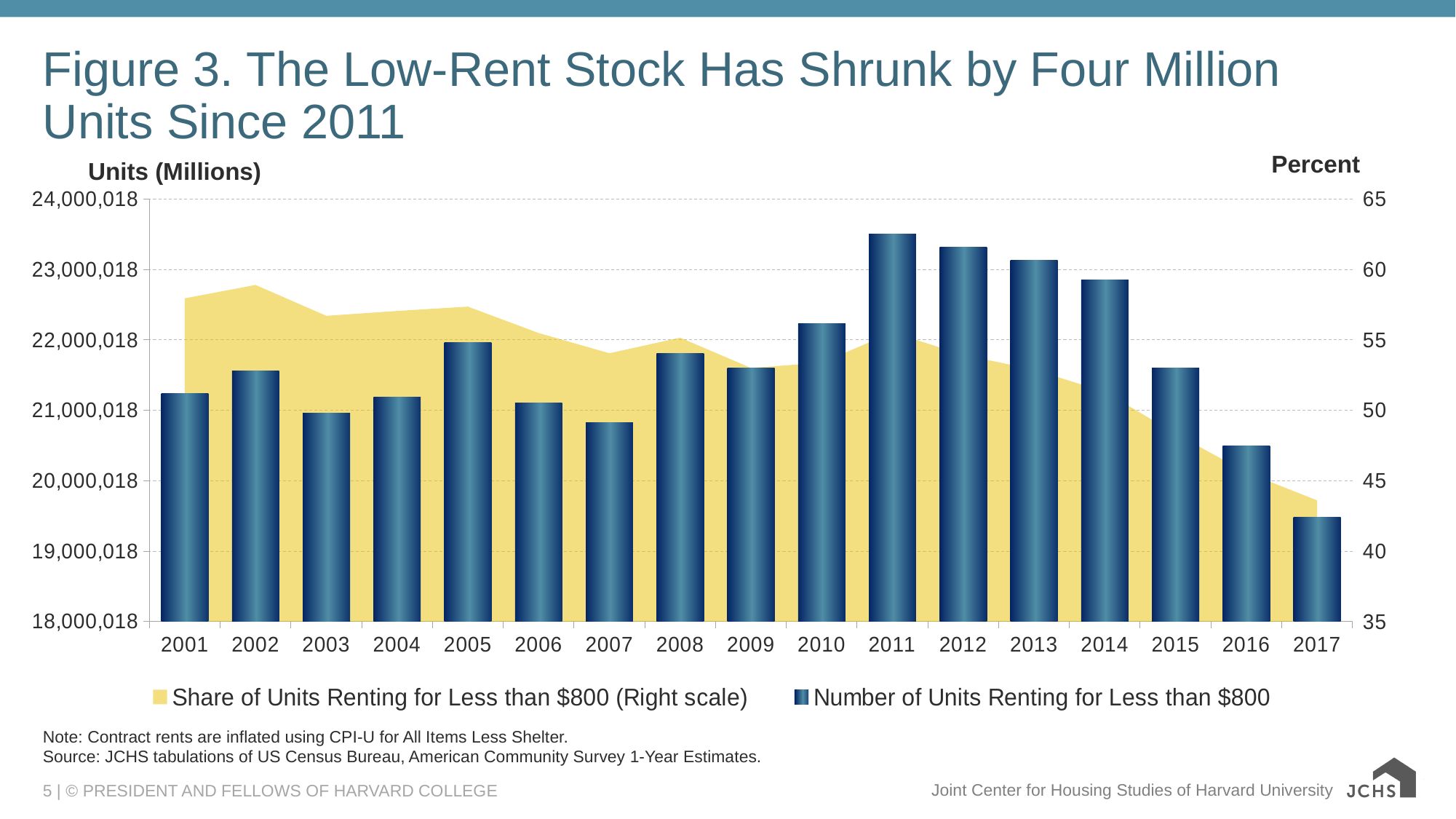
Do the bars for Number of Units Renting for Less than $800 rise or fall from 2011 to 2017? fall How many series does the legend list? 2 How many years are shown on the x axis? 17 Which is larger, the Number of Units Renting for Less than $800 in 2014 or in 2015? 2014 Is the Number of Units Renting for Less than $800 in 2011 greater or less than 23,000,018? greater Is the Share of Units Renting for Less than $800 in 2017 greater or less than 45 percent? less Which year has the highest bar for Number of Units Renting for Less than $800? 2011 What kind of chart is used for the Number of Units Renting for Less than $800 series? bar chart Is the Number of Units Renting for Less than $800 in 2010 greater or less than 22,000,018? greater What is the label of the right-hand axis? Percent Which year has the lowest bar for Number of Units Renting for Less than $800? 2017